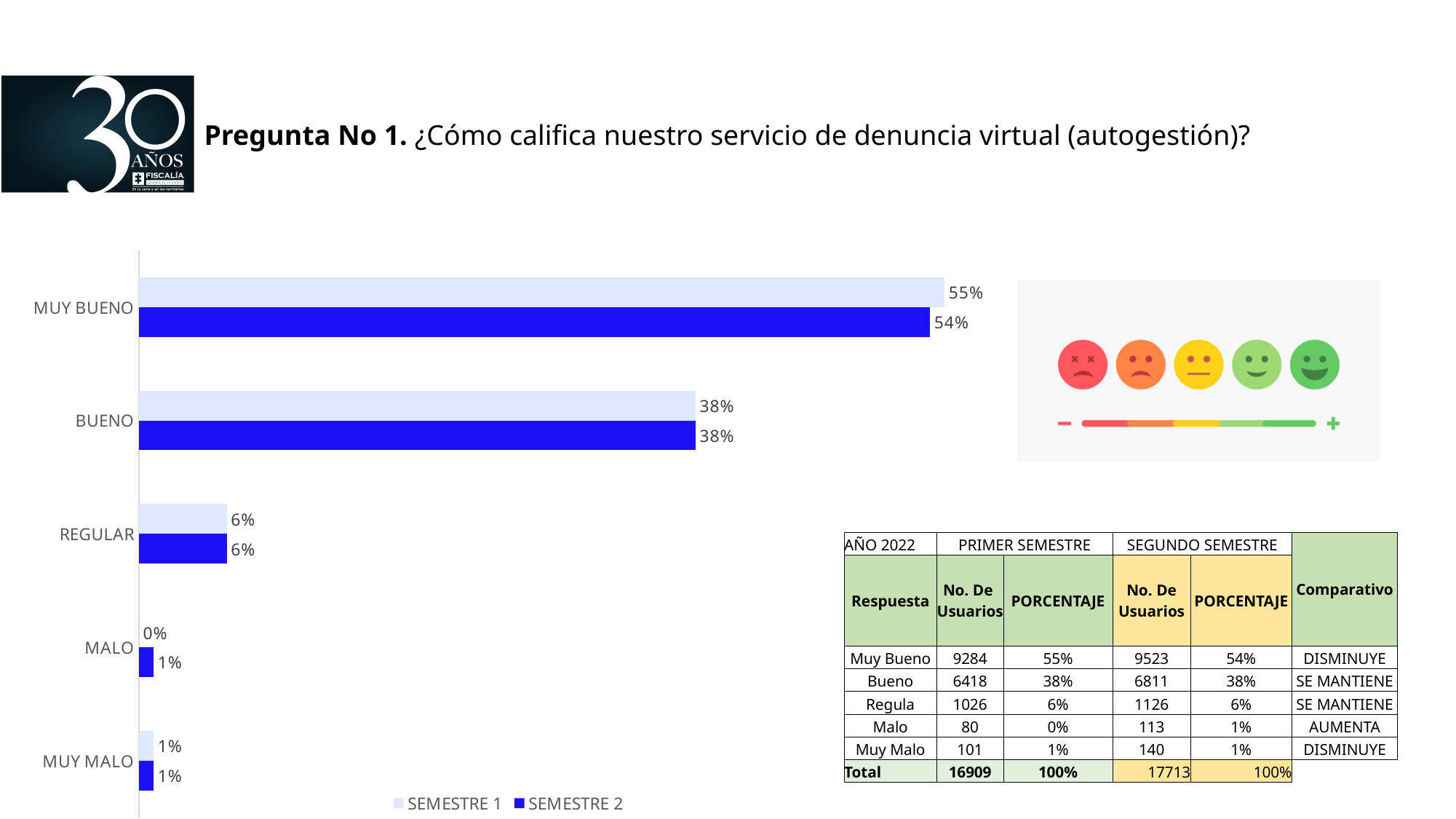
What is the value for MALO in the SEMESTRE 1 series? 0% Which category has the lowest value in the SEMESTRE 1 series? MALO What kind of chart is shown on the slide? bar chart What is the value for REGULAR in the SEMESTRE 1 series? 6% How many series does the legend list? 2 What is the value for MUY BUENO in the SEMESTRE 1 series? 55% What is the value for MUY BUENO in the SEMESTRE 2 series? 54% How many categories are shown on the chart? 5 Which category has the highest value in the SEMESTRE 2 series? MUY BUENO What is the difference between the SEMESTRE 1 and SEMESTRE 2 values for MUY BUENO? 1% Which is larger for MUY BUENO: the SEMESTRE 1 value or the SEMESTRE 2 value? SEMESTRE 1 What is the value for BUENO in the SEMESTRE 2 series? 38%